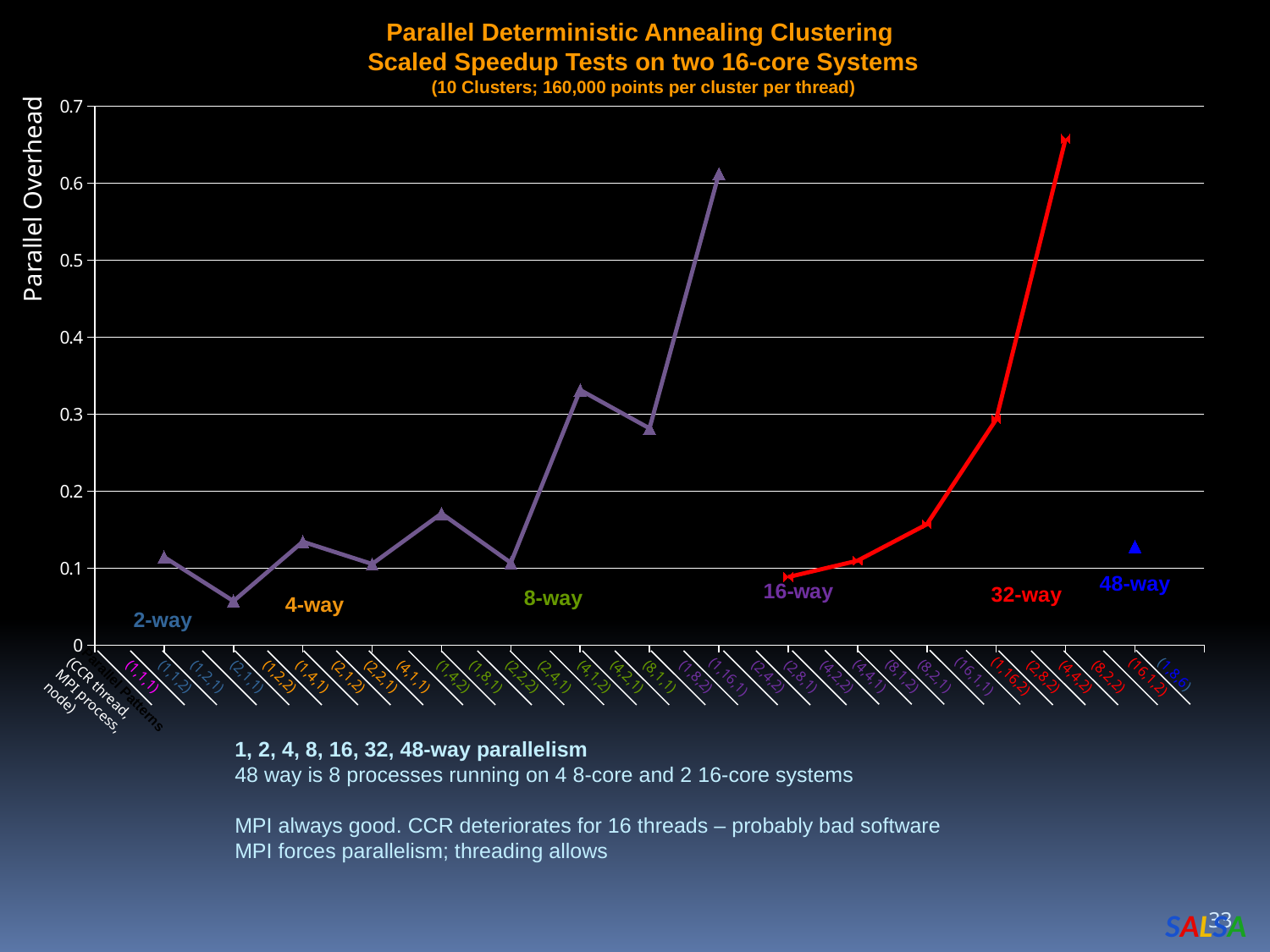
Is the highest point in the 32-way group greater or less than 0.6? greater How many parallelism groups (n-way labels) are marked on the chart? 6 Which parallelism group contains the lowest parallel overhead on the chart? 2-way Do the values in the 32-way group rise or fall from left to right? rise What is the highest tick value shown on the vertical axis? 0.7 What is the label on the vertical axis of the chart? Parallel Overhead Which parallelism group contains the highest parallel overhead on the chart? 32-way Is the value for the 48-way point greater or less than 0.1? greater Is the lowest point in the 2-way group greater or less than 0.1? less What kind of chart is shown on the slide? line chart